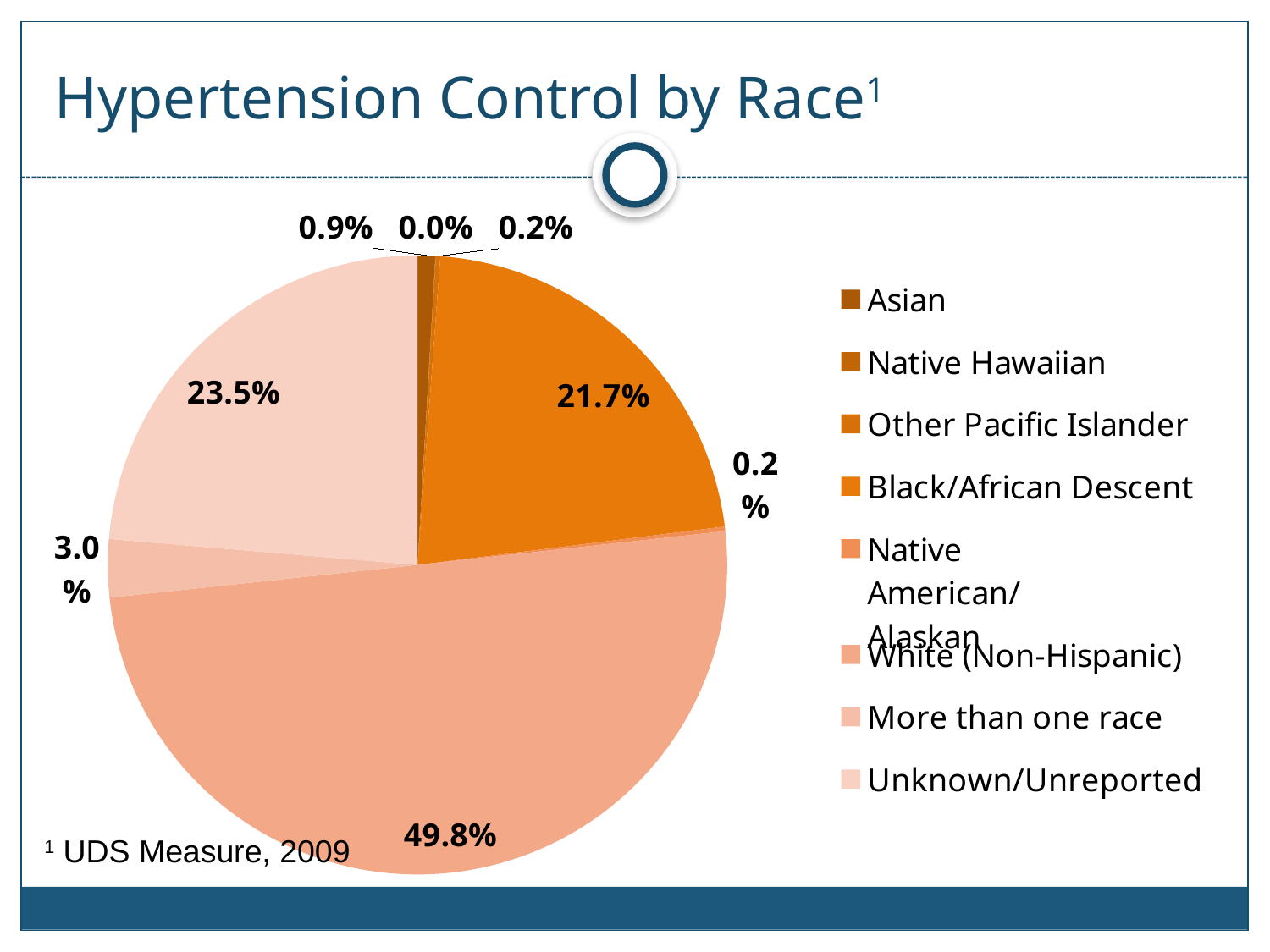
What percentage does the White (Non-Hispanic) slice represent? 49.8% Which category has the smallest value, at 0.0%? Native Hawaiian What type of chart is shown on the slide? Pie chart How many race categories does the legend list? 8 What percentage is labelled for Unknown/Unreported? 23.5% What is the difference between the White (Non-Hispanic) and Black/African Descent percentages? 28.1% What is the title of the chart on the slide? Hypertension Control by Race Which race category has the largest share of the pie? White (Non-Hispanic) What percentage is shown for Asian? 0.9% What is the value for More than one race? 3.0% What is the value shown for Black/African Descent? 21.7% Which is larger, Unknown/Unreported or Black/African Descent? Unknown/Unreported